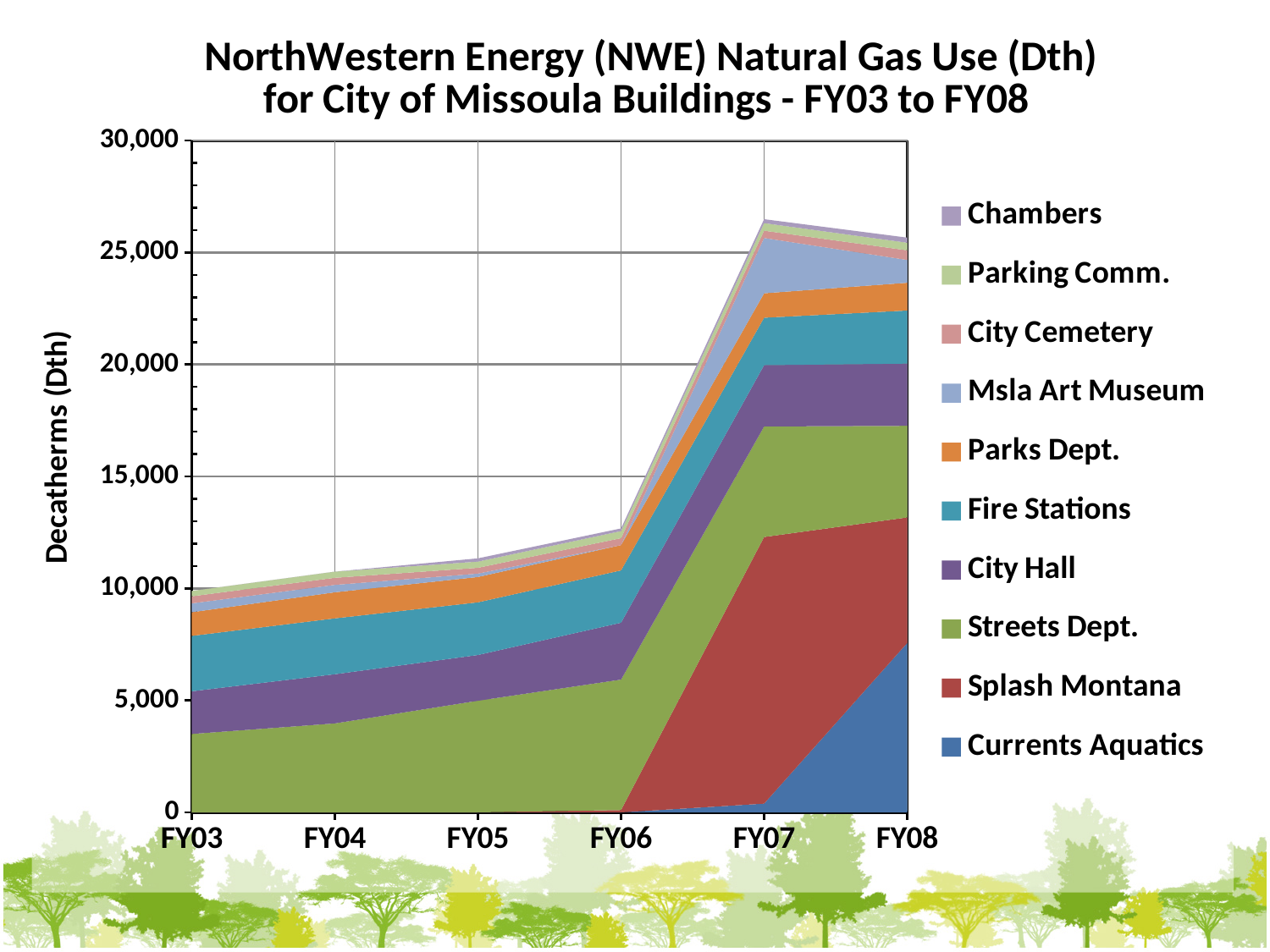
What kind of chart is shown on the slide? Stacked area chart Which fiscal year has the highest total natural gas use? FY07 Is the total natural gas use in FY05 greater or less than 10,000? greater Is the total natural gas use in FY06 greater or less than 15,000? less Which fiscal year has the larger total natural gas use, FY06 or FY07? FY07 Is the total natural gas use in FY07 greater or less than 25,000? greater Which fiscal year has the lowest total natural gas use? FY03 How many fiscal years are shown on the x axis? 6 How many series does the legend list? 10 What is the label on the y axis? Decatherms (Dth) Does the total natural gas use rise or fall from FY03 to FY07? Rise